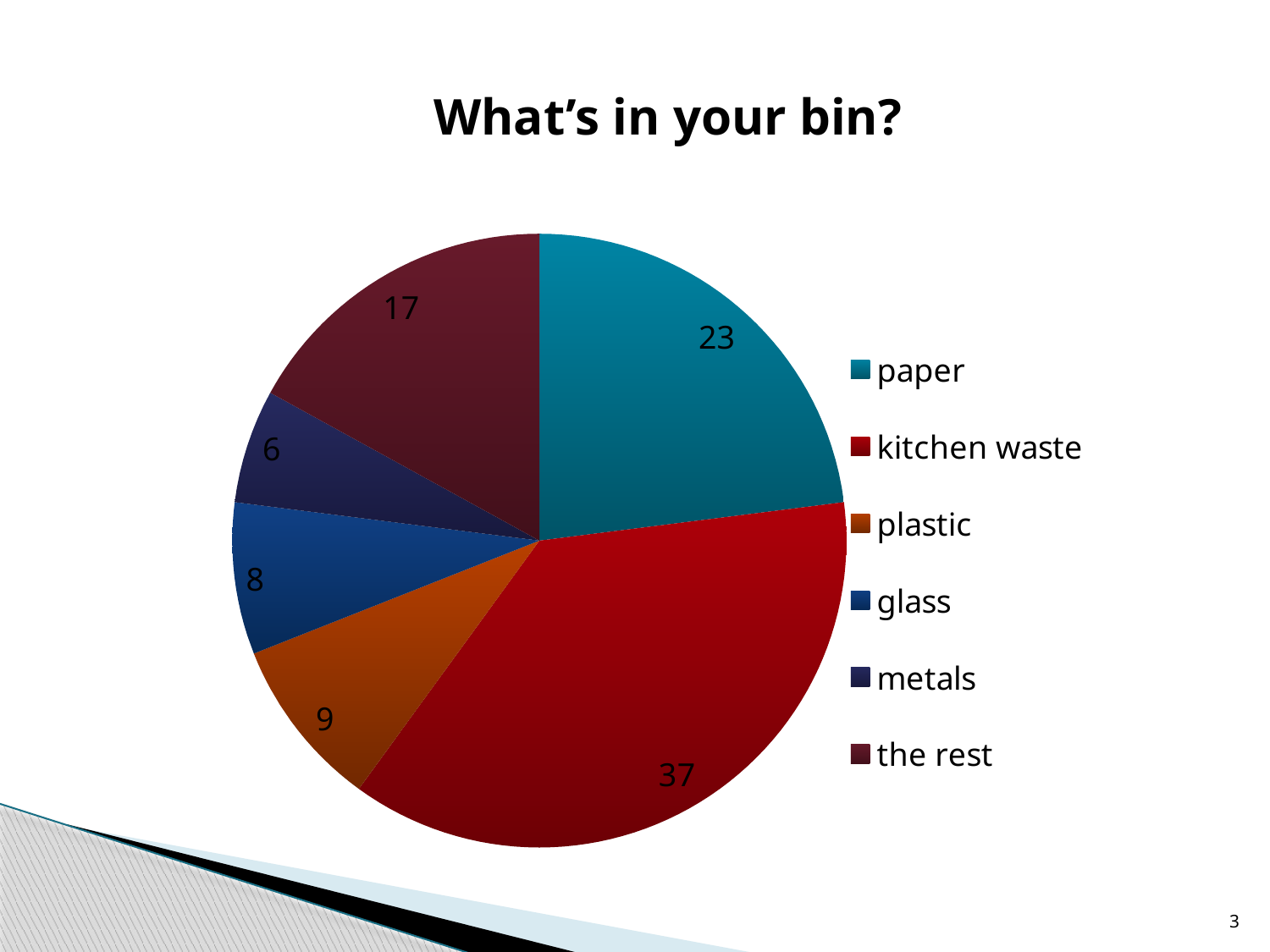
What is the difference between the values for the rest and plastic? 8 Which category has the largest slice? kitchen waste What is the value for paper? 23 What share of the pie does kitchen waste represent? 37% What is the difference between the values for kitchen waste and paper? 14 Which category has the smallest slice? metals What is the title of the chart? What's in your bin? Which is larger, plastic or glass? plastic What is the value for kitchen waste? 37 How many categories does the pie chart show? 6 What is the value for glass? 8 What kind of chart is shown on the slide? pie chart